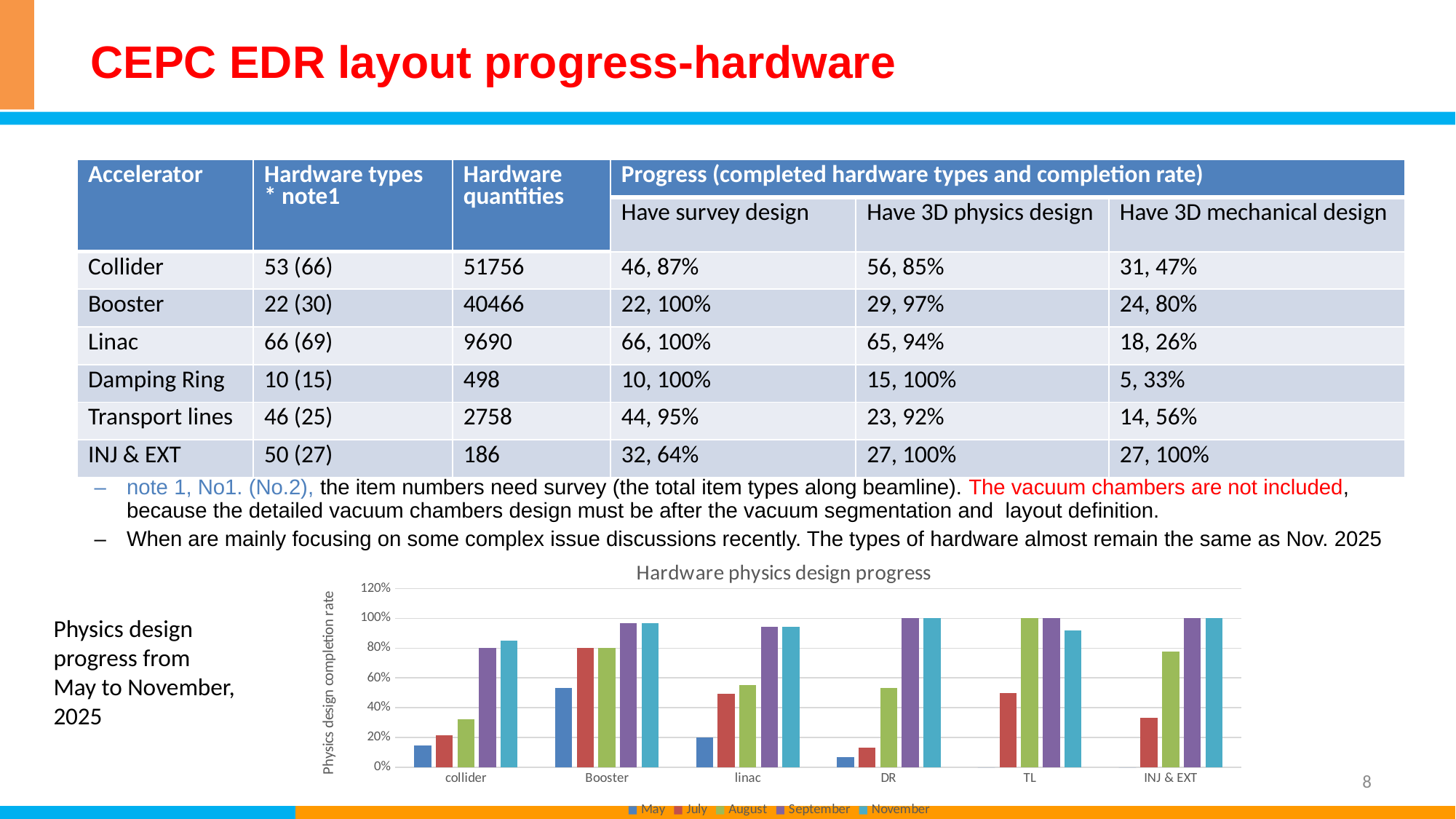
How many series does the chart legend list? 5 Is the May value for Booster greater or less than 40%? greater Is the November value for linac greater or less than 80%? greater What kind of chart is shown on the slide? bar chart Is the May value for collider greater or less than 20%? less What is the title of the chart? Hardware physics design progress How many accelerator categories are shown on the x axis of the chart? 6 Which month has the lowest value for collider? May Which is larger, the May value for Booster or the May value for linac? Booster What is the September value for DR in the chart? 100% Do the collider values rise or fall from May to November? rise